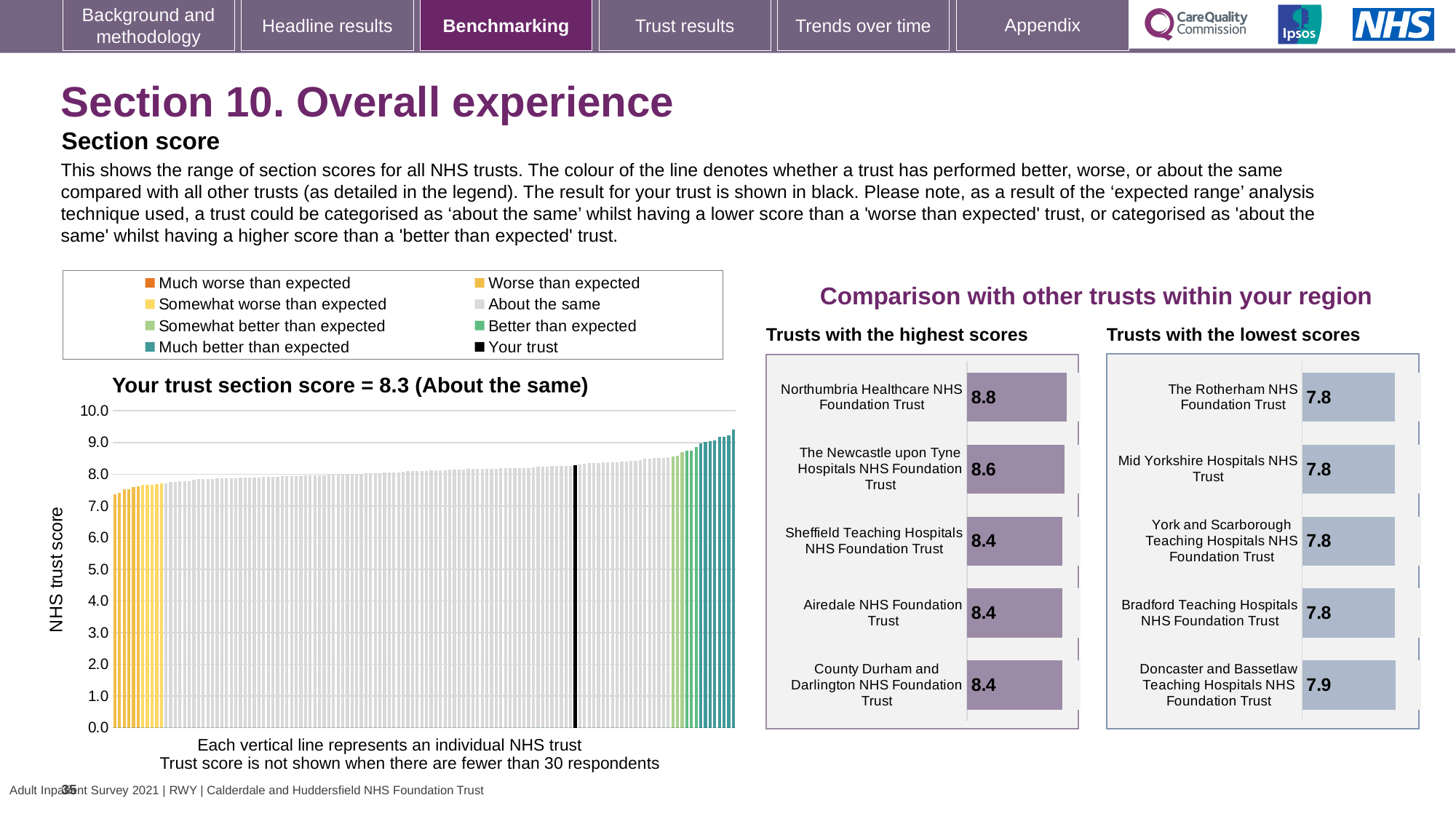
In the 'Your trust section score' chart, do the trust scores rise or fall from left to right along the x axis? Rise In the 'Your trust section score' chart, what is the section score for your trust? 8.3 What kind of chart is the 'Your trust section score' chart? Bar chart In the 'Trusts with the highest scores' chart, how many trusts are listed? 5 In the 'Trusts with the lowest scores' chart, what is the score for Bradford Teaching Hospitals NHS Foundation Trust? 7.8 How many entries does the legend above the 'Your trust section score' chart list? 8 In the 'Trusts with the highest scores' chart, what is the difference between the scores of Northumbria Healthcare NHS Foundation Trust and The Newcastle upon Tyne Hospitals NHS Foundation Trust? 0.2 In the 'Trusts with the highest scores' chart, which trust has the highest score? Northumbria Healthcare NHS Foundation Trust In the 'Trusts with the lowest scores' chart, which has the larger score: The Rotherham NHS Foundation Trust or Doncaster and Bassetlaw Teaching Hospitals NHS Foundation Trust? Doncaster and Bassetlaw Teaching Hospitals NHS Foundation Trust In the 'Trusts with the highest scores' chart, what is the score for Northumbria Healthcare NHS Foundation Trust? 8.8 In the 'Trusts with the lowest scores' chart, what is the score for Doncaster and Bassetlaw Teaching Hospitals NHS Foundation Trust? 7.9 In the 'Trusts with the lowest scores' chart, which trust has the highest score? Doncaster and Bassetlaw Teaching Hospitals NHS Foundation Trust